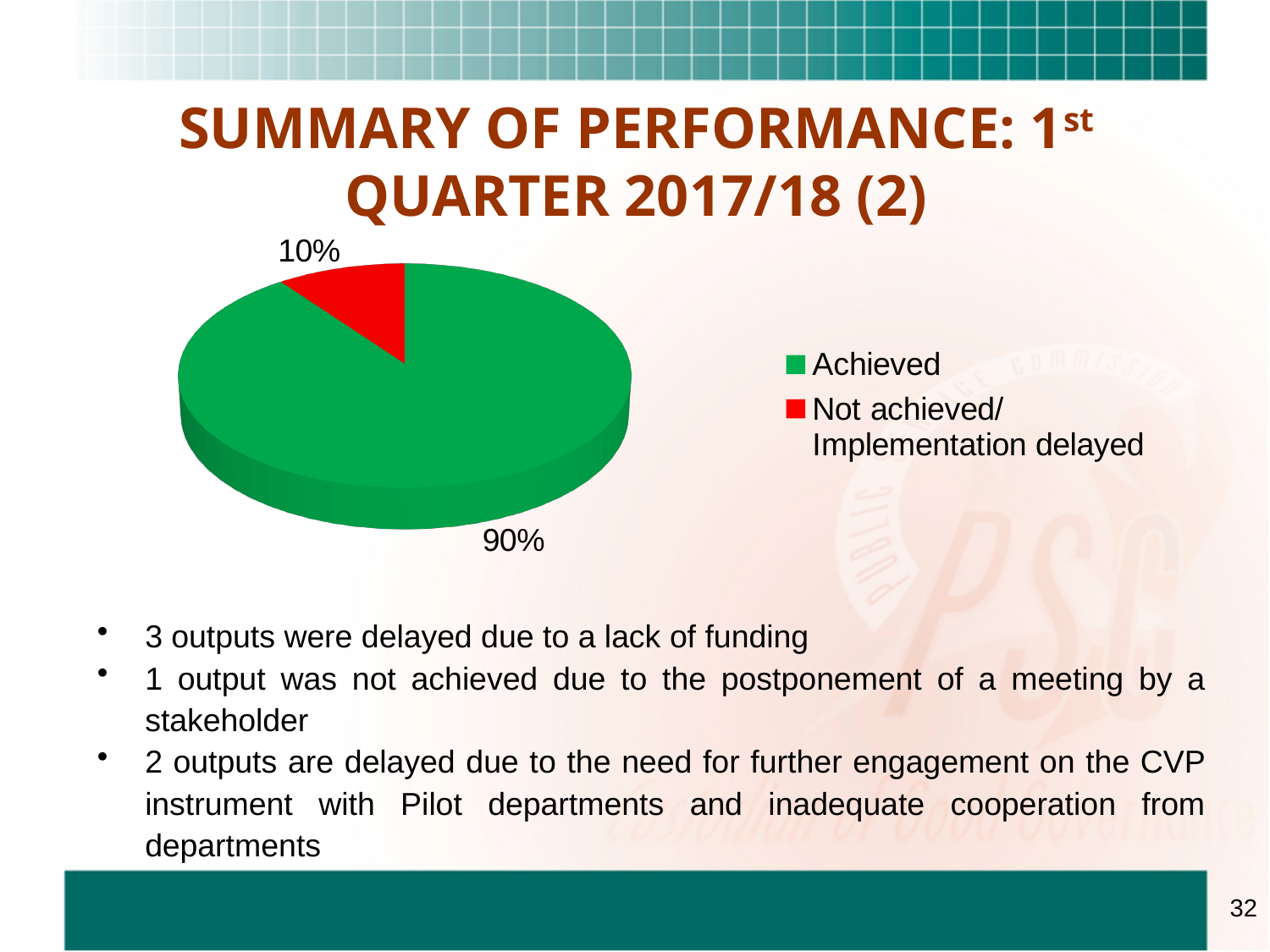
How many slices does the pie chart have? 2 What colour is the Achieved slice? green What colour is the Not achieved/ Implementation delayed slice? red How many entries does the legend list? 2 Which category has the largest share of the pie? Achieved What percentage of the pie is labelled Not achieved/ Implementation delayed? 10% Is the share for Achieved greater or less than 50%? greater What kind of chart is shown on the slide? pie chart What is the difference in percentage points between the Achieved and Not achieved/ Implementation delayed slices? 80 What percentage of the pie is labelled Achieved? 90% Which category has the smallest share of the pie? Not achieved/ Implementation delayed Which is larger: the Achieved slice or the Not achieved/ Implementation delayed slice? Achieved